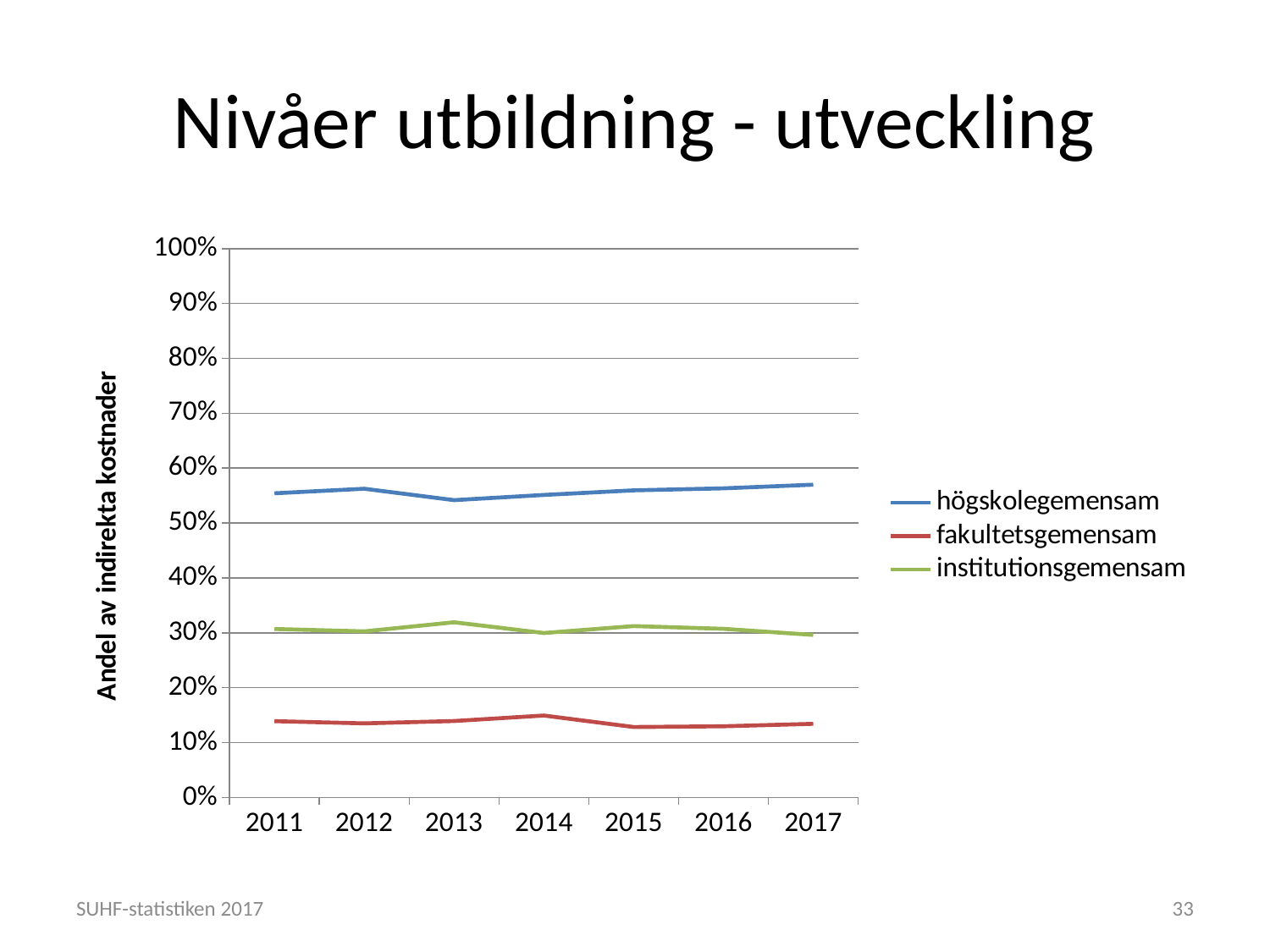
In 2015, which is larger: institutionsgemensam or fakultetsgemensam? institutionsgemensam How many series does the legend list? 3 Does the högskolegemensam line rise or fall from 2013 to 2017? rise Is the value for högskolegemensam in 2013 greater or less than 60%? less Which series has the highest values across all years? högskolegemensam What is the label on the y axis of the chart? Andel av indirekta kostnader How many years are shown on the x axis? 7 Is the value for högskolegemensam in 2011 greater or less than 50%? greater Which series has the lowest values across all years? fakultetsgemensam Is the value for institutionsgemensam in 2013 greater or less than 40%? less What kind of chart is shown on the slide? Line chart